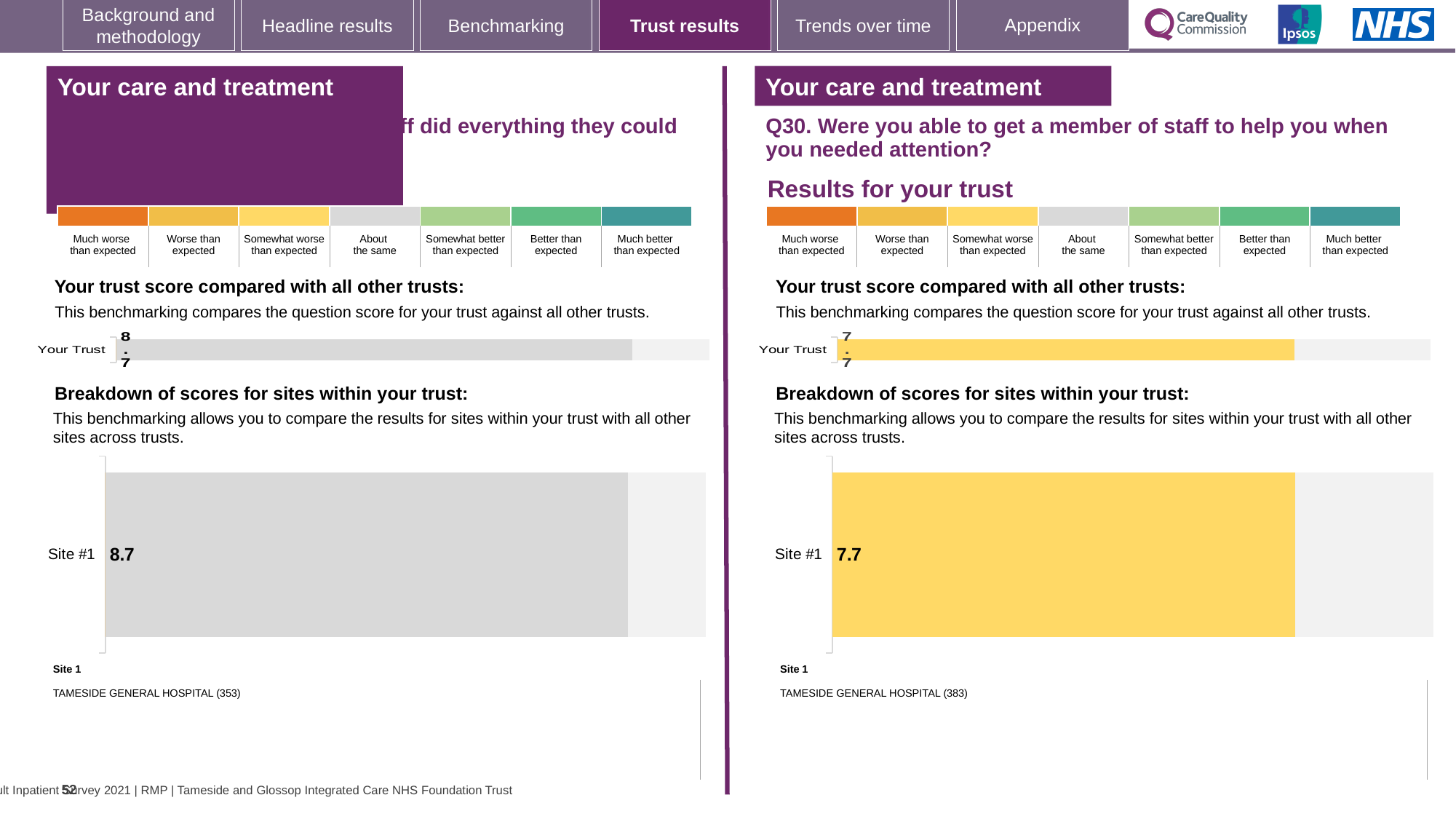
What type of chart is used to show the Site #1 score on the right half of the slide (Q30)? Bar chart Which Site #1 score is larger: the one on the left half of the slide or the one for Q30 on the right half? The left half (8.7) On the right half of the slide (Q30), what is the 'Your Trust' score in the chart comparing the trust score with all other trusts? 7.7 How many sites are shown in the breakdown of scores chart on the left half of the slide? 1 On the left half of the slide, what is the score shown for Site #1 in the breakdown of scores for sites within your trust? 8.7 On the right half of the slide (Q30), which hospital is listed as Site 1 below the chart? TAMESIDE GENERAL HOSPITAL (383) According to the colour key, which benchmarking category does the yellow Site #1 bar for Q30 on the right half of the slide represent? Somewhat worse than expected On the left half of the slide, what is the 'Your Trust' score in the chart comparing the trust score with all other trusts? 8.7 What is the difference between the Site #1 score on the left half of the slide and the Site #1 score for Q30 on the right half? 1.0 How many sites are shown in the breakdown of scores chart for Q30 on the right half of the slide? 1 On the right half of the slide (Q30), what is the score shown for Site #1 in the breakdown of scores for sites within your trust? 7.7 According to the colour key, which benchmarking category does the grey Site #1 bar on the left half of the slide represent? About the same